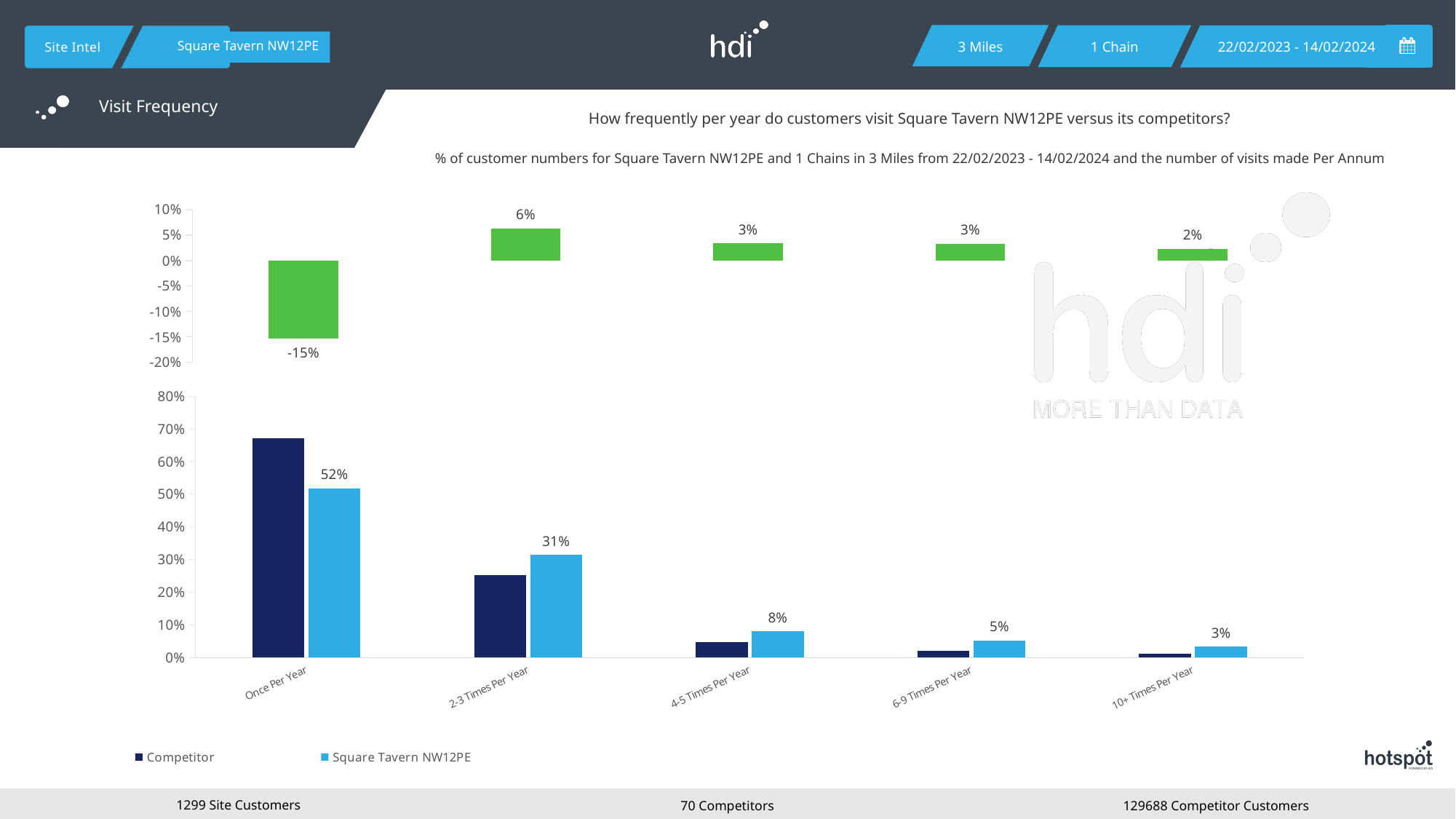
How many categories are shown on the x axis of the bottom chart? 5 How many series does the legend of the bottom chart list? 2 In the bottom chart, what is the value for Square Tavern NW12PE for 10+ Times Per Year? 3% In the bottom chart, what is the value for Square Tavern NW12PE for Once Per Year? 52% In the top chart, what is the value of the first (leftmost) green bar? -15% In the bottom chart, is the Competitor value for Once Per Year greater or less than 60%? greater In the bottom chart, for 2-3 Times Per Year, which is larger: Competitor or Square Tavern NW12PE? Square Tavern NW12PE In the bottom chart, what is the value for Square Tavern NW12PE for 2-3 Times Per Year? 31% In the bottom chart, what is the difference between the Square Tavern NW12PE values for Once Per Year and 2-3 Times Per Year? 21 percentage points In the bottom chart, is the Competitor value for 2-3 Times Per Year greater or less than 30%? less In the bottom chart, for Once Per Year, which is larger: Competitor or Square Tavern NW12PE? Competitor In the bottom chart, which category has the highest value for Square Tavern NW12PE? Once Per Year